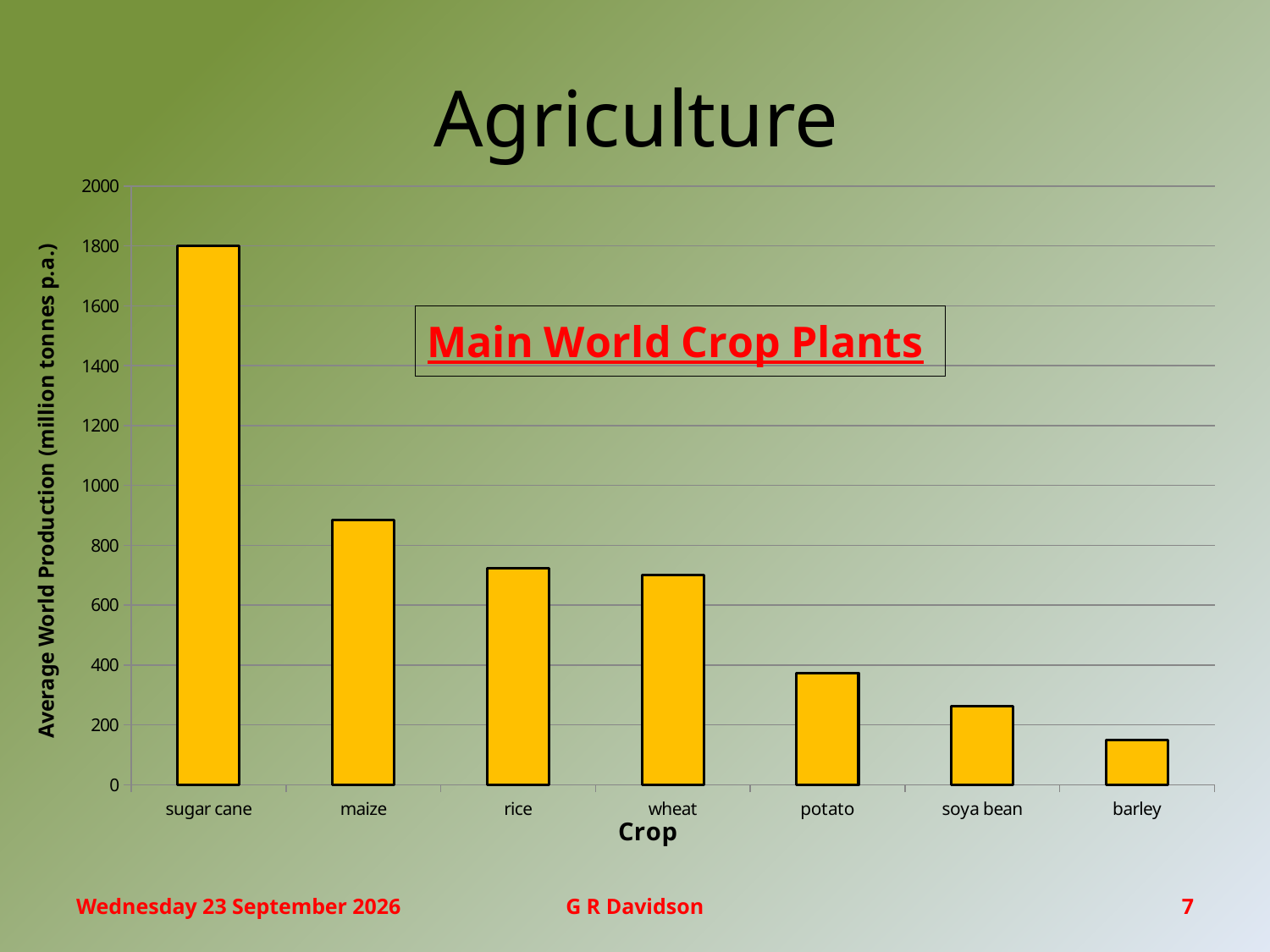
What is the average world production for sugar cane, in million tonnes p.a.? 1800 Is the value for barley greater or less than 200? less Which has the larger average world production, maize or rice? maize Is the value for maize greater or less than 800? greater Which crop has the lowest average world production? barley Is the value for soya bean greater or less than 200? greater What kind of chart is shown on the slide? bar chart What is the label on the y axis of the chart? Average World Production (million tonnes p.a.) Do the values rise or fall moving from left to right along the x axis? fall How many crops are shown on the x axis of the chart? 7 Which crop has the highest average world production? sugar cane